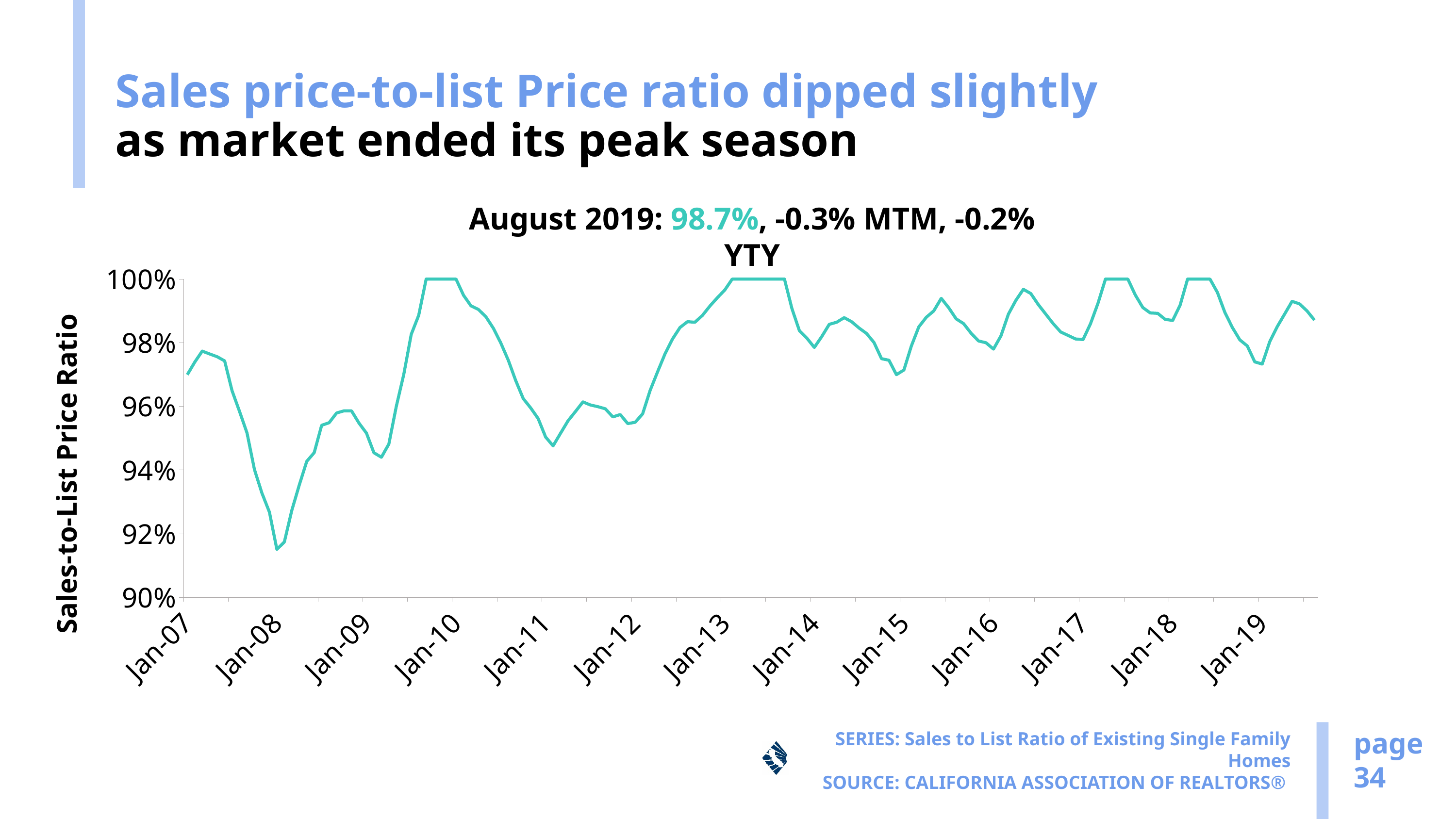
What was the month-to-month (MTM) change in the ratio for August 2019? -0.3% Does the ratio rise or fall between Jan-07 and Jan-08? fall In which year did the sales-to-list price ratio reach its lowest point? 2008 What was the year-to-year (YTY) change in the ratio for August 2019? -0.2% Which is larger, the value at Jan-08 or the value at Jan-10? Jan-10 What was the sales-to-list price ratio in August 2019? 98.7% What is the label on the y axis? Sales-to-List Price Ratio Is the value at Jan-12 greater or less than 98%? less How many year labels are shown on the x axis? 13 What kind of chart is shown on the slide? line chart Is the value at Jan-08 greater or less than 96%? less Is the value at Jan-10 greater or less than 98%? greater